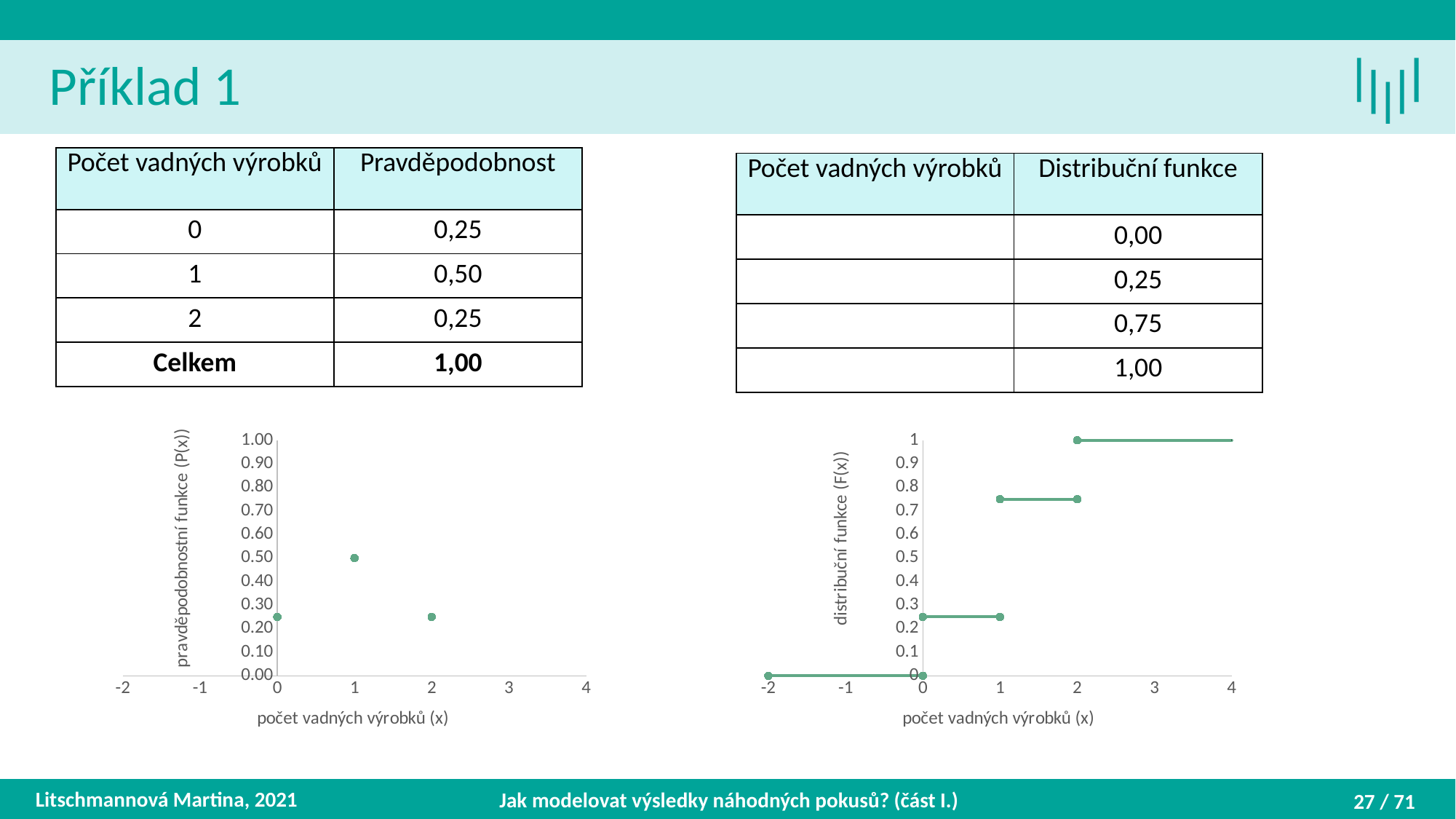
In the left chart, at which value of x is the plotted point highest? 1 What kind of chart is the left chart? scatter chart In the right chart, is the value of F(x) between x = 1 and x = 2 greater or less than 0.7? greater In the right chart, what is the value of F(x) for x between -2 and 0? 0 In the left chart, which point is higher: the one at x = 1 or the one at x = 2? x = 1 In the left chart, is the value at x = 0 greater or less than 0.20? greater What is the x-axis label of the right chart? počet vadných výrobků (x) In the left chart, how many data points are plotted? 3 In the left chart, is the value at x = 2 greater or less than 0.30? less In the left chart (pravděpodobnostní funkce), what is the value of P(x) at x = 1? 0.50 In the right chart (distribuční funkce), what is the value of F(x) for x between 2 and 4? 1 In the right chart, do the values rise or fall as x increases? rise